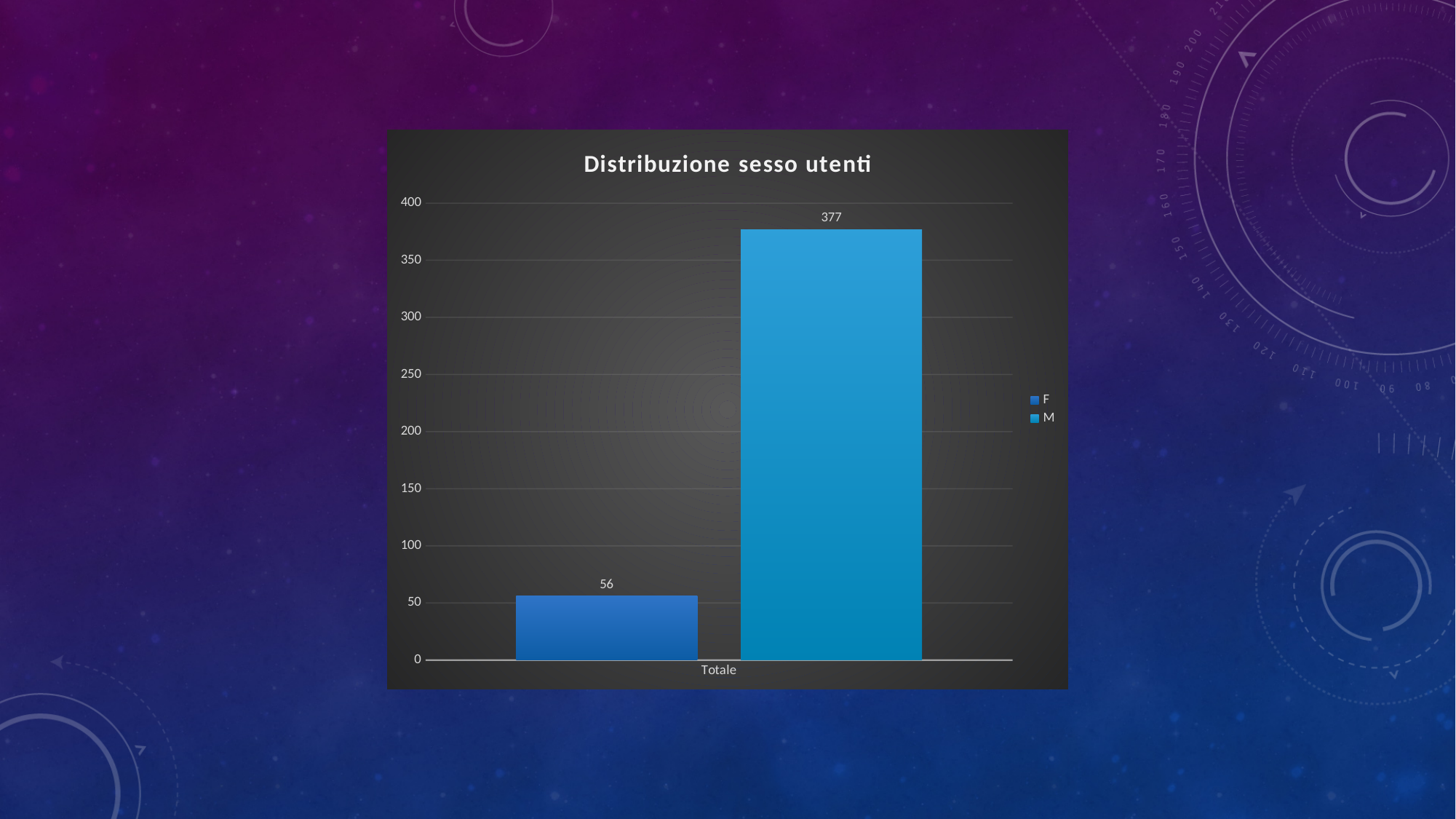
Is the value for M greater or less than 350? greater What is the difference between the values for M and F? 321 What is the value for F in the chart? 56 Is the value for F greater or less than 100? less What kind of chart is shown on the slide? Bar chart How many series does the legend list? 2 What is the category label on the x axis? Totale Which series has the lowest value? F Which series has the highest value? M What is the value for M in the chart? 377 Which is larger, the value for F or the value for M? M What is the title of the chart? Distribuzione sesso utenti